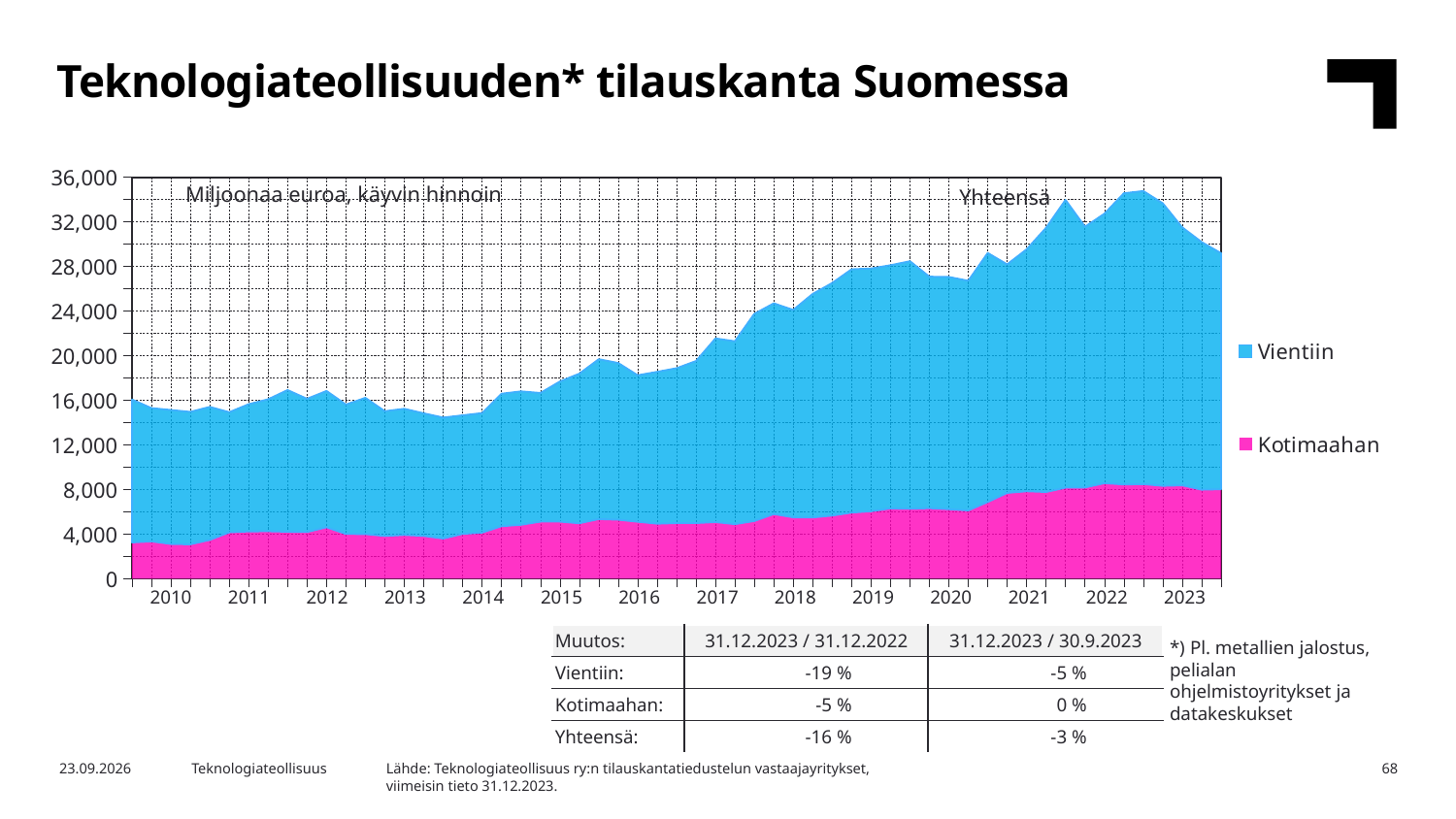
What are the two series named in the chart legend? Vientiin and Kotimaahan Which series is larger throughout the chart, Vientiin or Kotimaahan? Vientiin Is the peak total (Yhteensä) value in 2022 greater or less than 32,000? greater Does the total (Yhteensä) order backlog generally rise or fall from 2010 to 2023? rise Is the Kotimaahan value at the start of 2010 greater or less than 4,000? less What is the title of the chart on the slide? Teknologiateollisuuden* tilauskanta Suomessa Does the Kotimaahan series generally rise or fall from 2010 to 2023? rise What kind of chart is shown on the slide? Stacked area chart How many series does the chart legend list? 2 Is the total (Yhteensä) value at the start of 2010 greater or less than 12,000? greater How many years are labelled on the x axis of the chart? 14